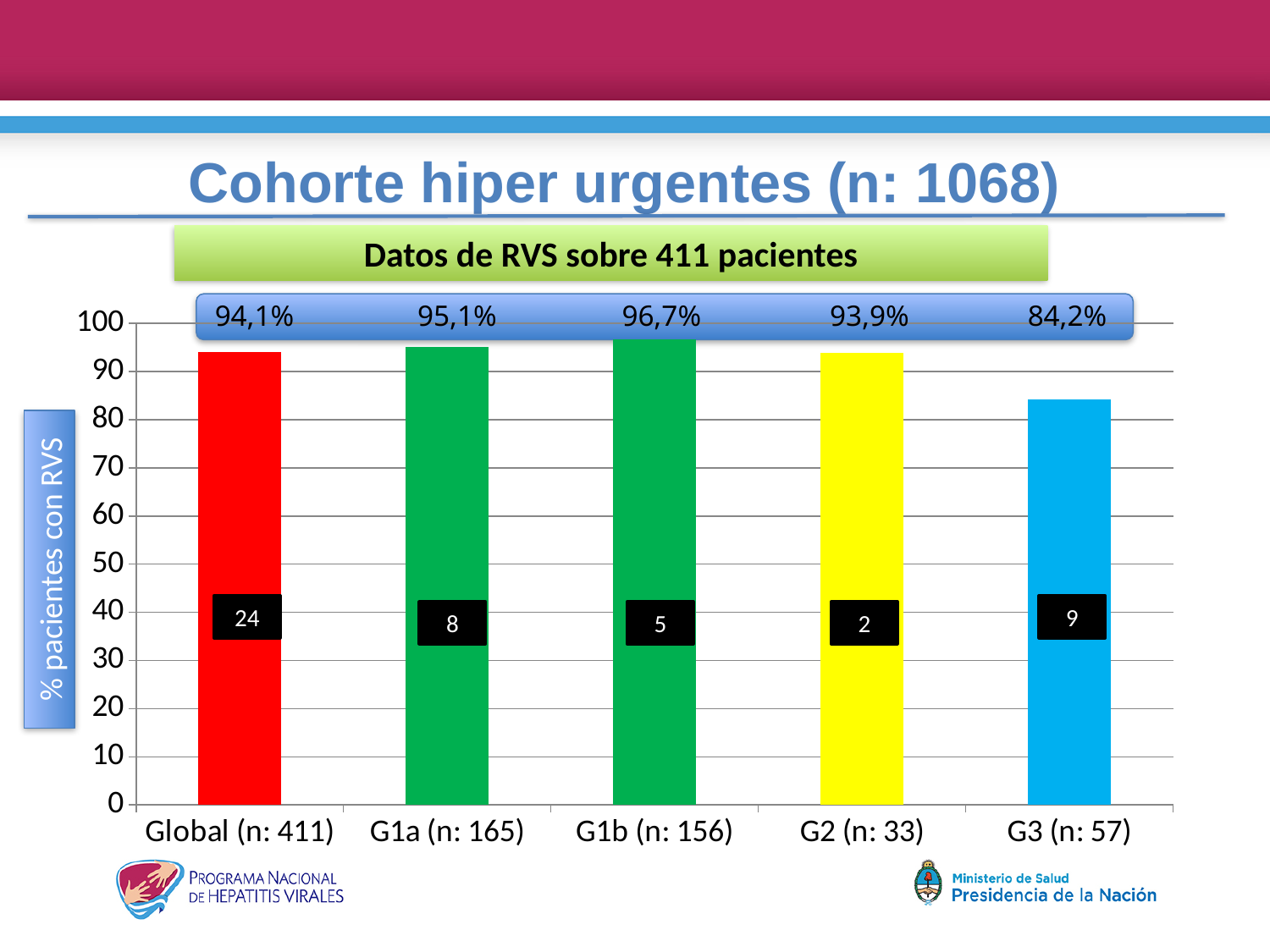
What kind of chart is shown on the slide? bar chart What is the % pacientes con RVS value for Global (n: 411)? 94,1% Which category has the lowest % pacientes con RVS? G3 (n: 57) How many categories are shown on the x axis of the chart? 5 Which has a higher % pacientes con RVS, G1a (n: 165) or G2 (n: 33)? G1a (n: 165) What is the % pacientes con RVS value for G1b (n: 156)? 96,7% What is the label of the y axis of the chart? % pacientes con RVS What number is printed in the black box on the G2 (n: 33) bar? 2 What is the % pacientes con RVS value for G3 (n: 57)? 84,2% Which category has the highest % pacientes con RVS? G1b (n: 156) Is the value for G3 (n: 57) greater or less than 90? less What is the difference in % pacientes con RVS between G1b (n: 156) and G3 (n: 57)? 12,5%